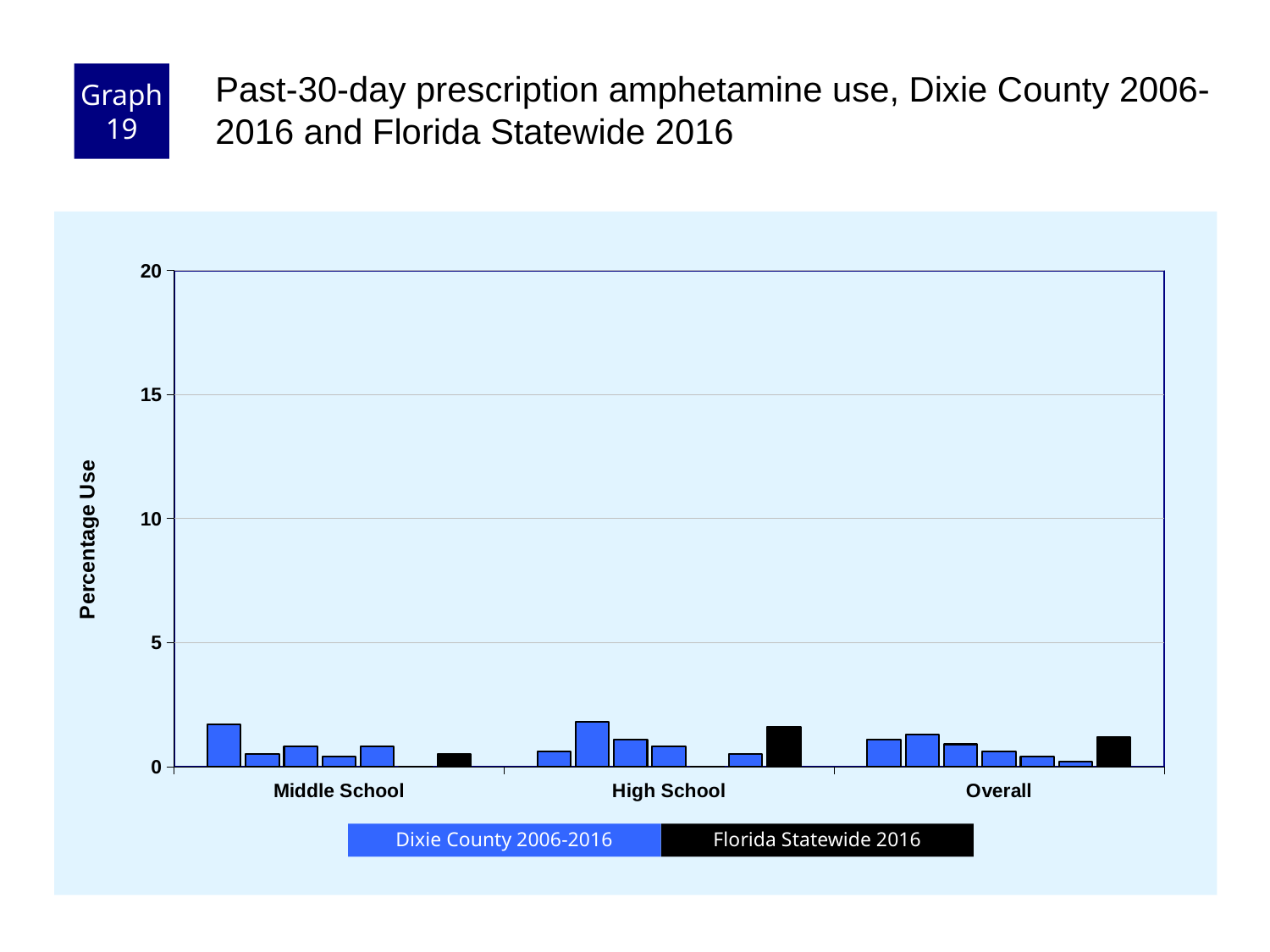
What kind of chart is shown on the slide? bar chart What is the label on the y axis? Percentage Use Is the Florida Statewide 2016 bar larger for High School or for Middle School? High School Which colour represents Florida Statewide 2016 in the legend? black Is the Florida Statewide 2016 value for Middle School greater or less than 5? less Is the Florida Statewide 2016 bar larger for Overall or for Middle School? Overall How many school-level categories are shown on the x axis? 3 How many series does the legend list? 2 Is the Florida Statewide 2016 value for Overall greater or less than 10? less Is the Florida Statewide 2016 value for High School greater or less than 5? less Which category has the lowest Florida Statewide 2016 bar? Middle School Which category has the highest Florida Statewide 2016 bar? High School